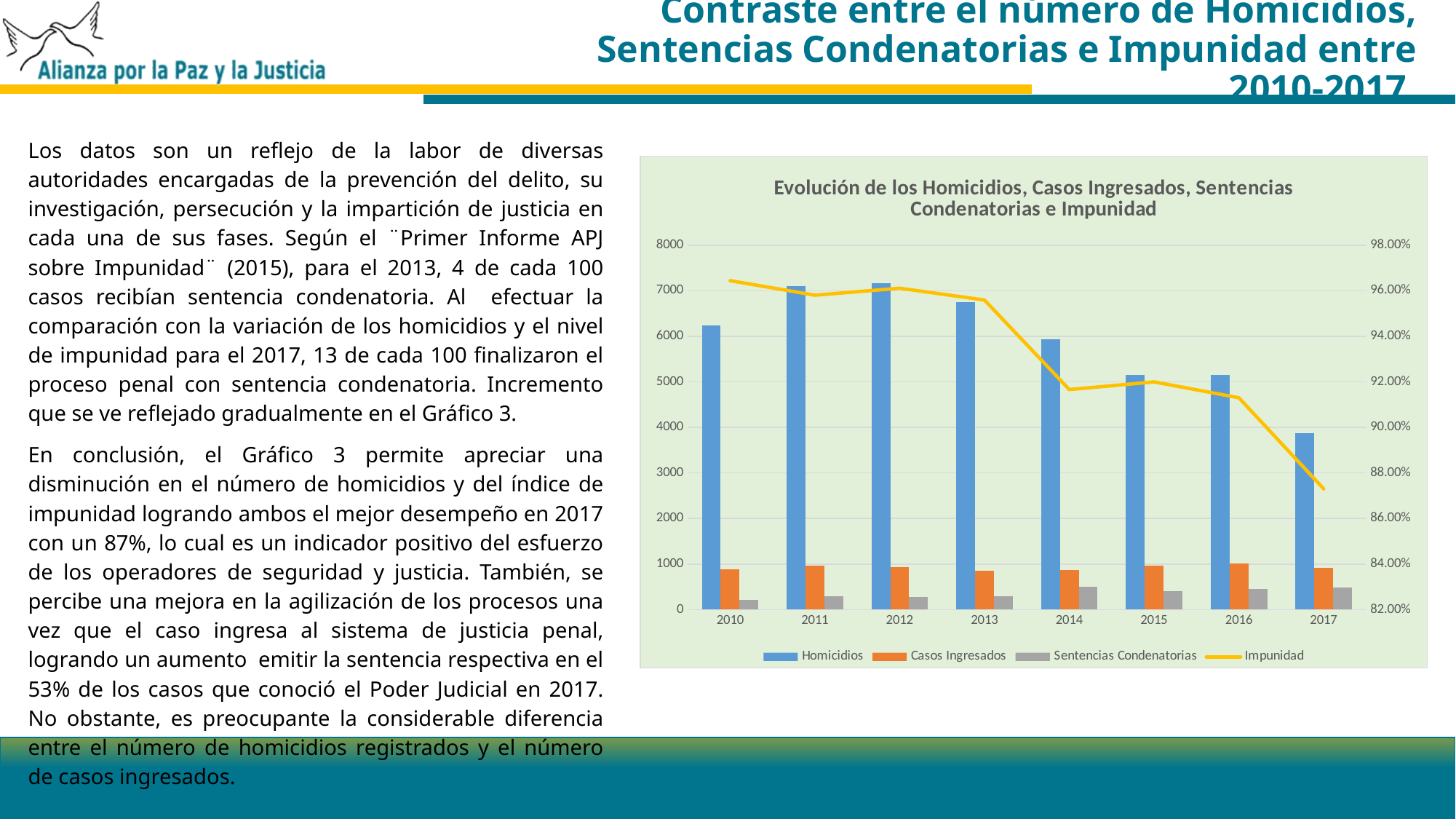
In which year is the Impunidad line at its lowest? 2017 Is the Homicidios value for 2010 greater or less than 6000? greater What kind of chart is shown on the slide? A combined bar and line chart Is the Casos Ingresados value for 2010 greater or less than 1000? less Which is larger, the Homicidios value for 2013 or for 2014? 2013 Which year has the lowest Homicidios bar? 2017 Is the Homicidios value for 2017 greater or less than 4000? less How many years are shown on the x axis of the chart? 8 In which year is the Impunidad line at its highest? 2010 Does the Impunidad line rise or fall from 2010 to 2017? Fall How many series does the chart legend list? 4